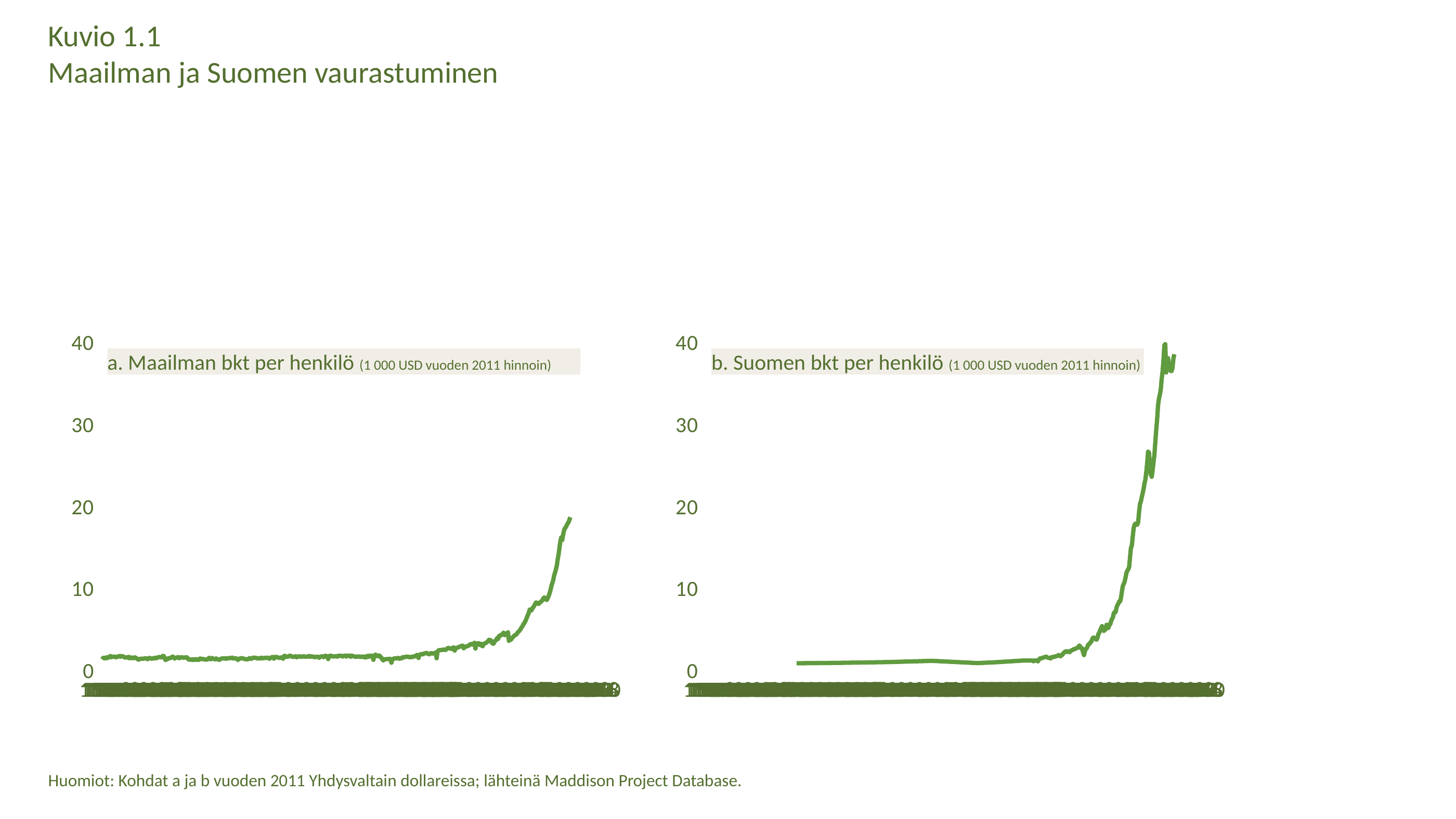
What unit is given in parentheses in the title of chart a? 1 000 USD vuoden 2011 hinnoin What kind of chart is chart a, "Maailman bkt per henkilö"? line chart Which chart reaches a higher peak value, chart a (Maailman bkt per henkilö) or chart b (Suomen bkt per henkilö)? chart b (Suomen bkt per henkilö) In chart a, "Maailman bkt per henkilö", is the final value of the line greater or less than 20? less What kind of chart is chart b, "Suomen bkt per henkilö"? line chart In chart b, "Suomen bkt per henkilö", do the values rise or fall overall along the x axis? rise In chart b, "Suomen bkt per henkilö", is the highest value of the line greater or less than 30? greater What is the main title of the slide above the charts? Kuvio 1.1 Maailman ja Suomen vaurastuminen How many lines are plotted in chart b, "Suomen bkt per henkilö"? 1 In chart a, "Maailman bkt per henkilö", is the final value of the line greater or less than 10? greater In chart a, "Maailman bkt per henkilö", do the values rise or fall overall along the x axis? rise